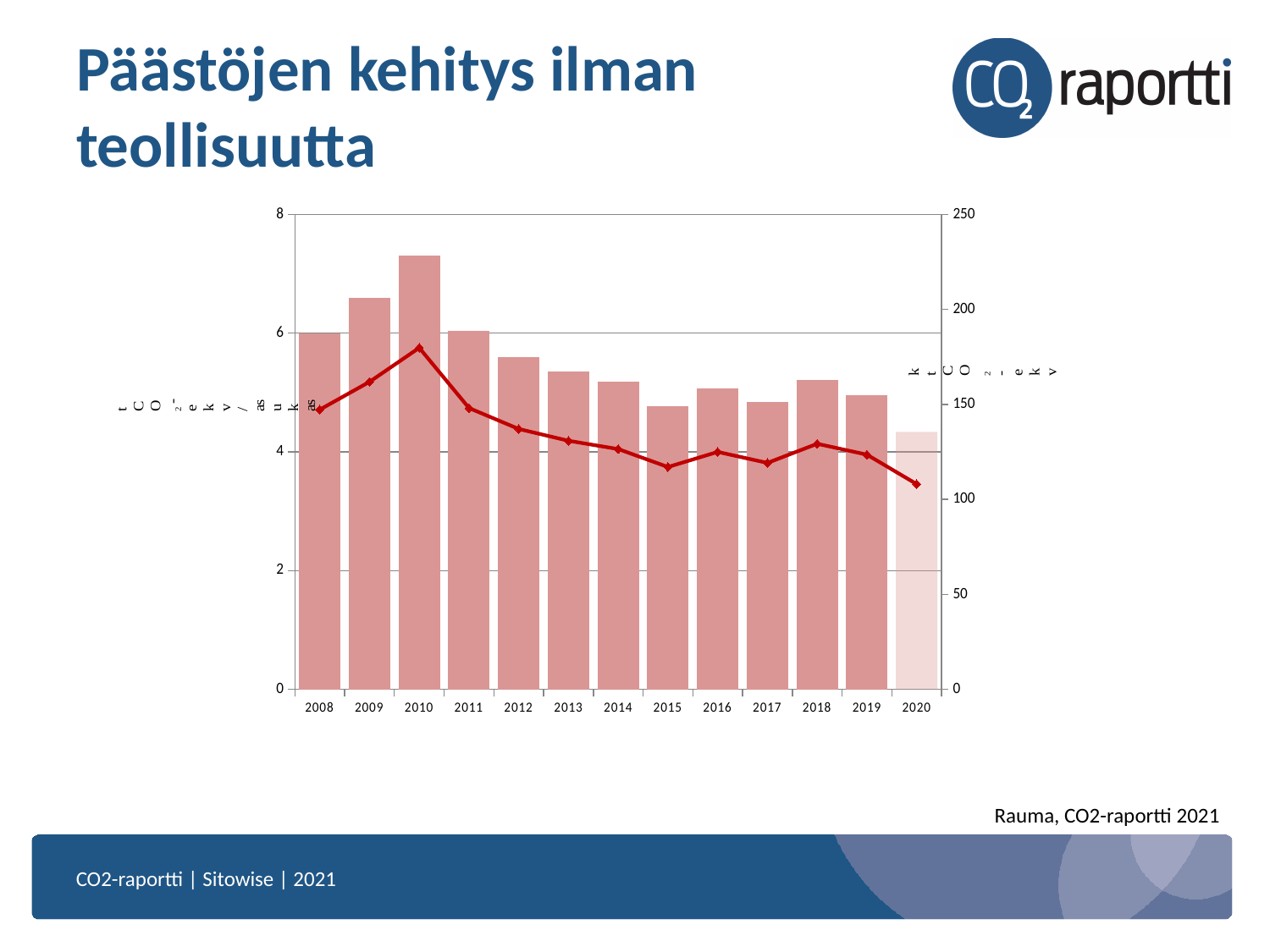
In which year does the red line reach its lowest point? 2020 Do the bars generally rise or fall from 2010 to 2015? fall Which year has the shortest bar in the chart? 2020 How many years are shown on the x axis of the chart? 13 Which year has the tallest bar in the chart? 2010 What kind of chart is shown on the slide? A combined bar and line chart Which bar is taller, 2009 or 2011? 2009 In which year does the red line reach its highest point? 2010